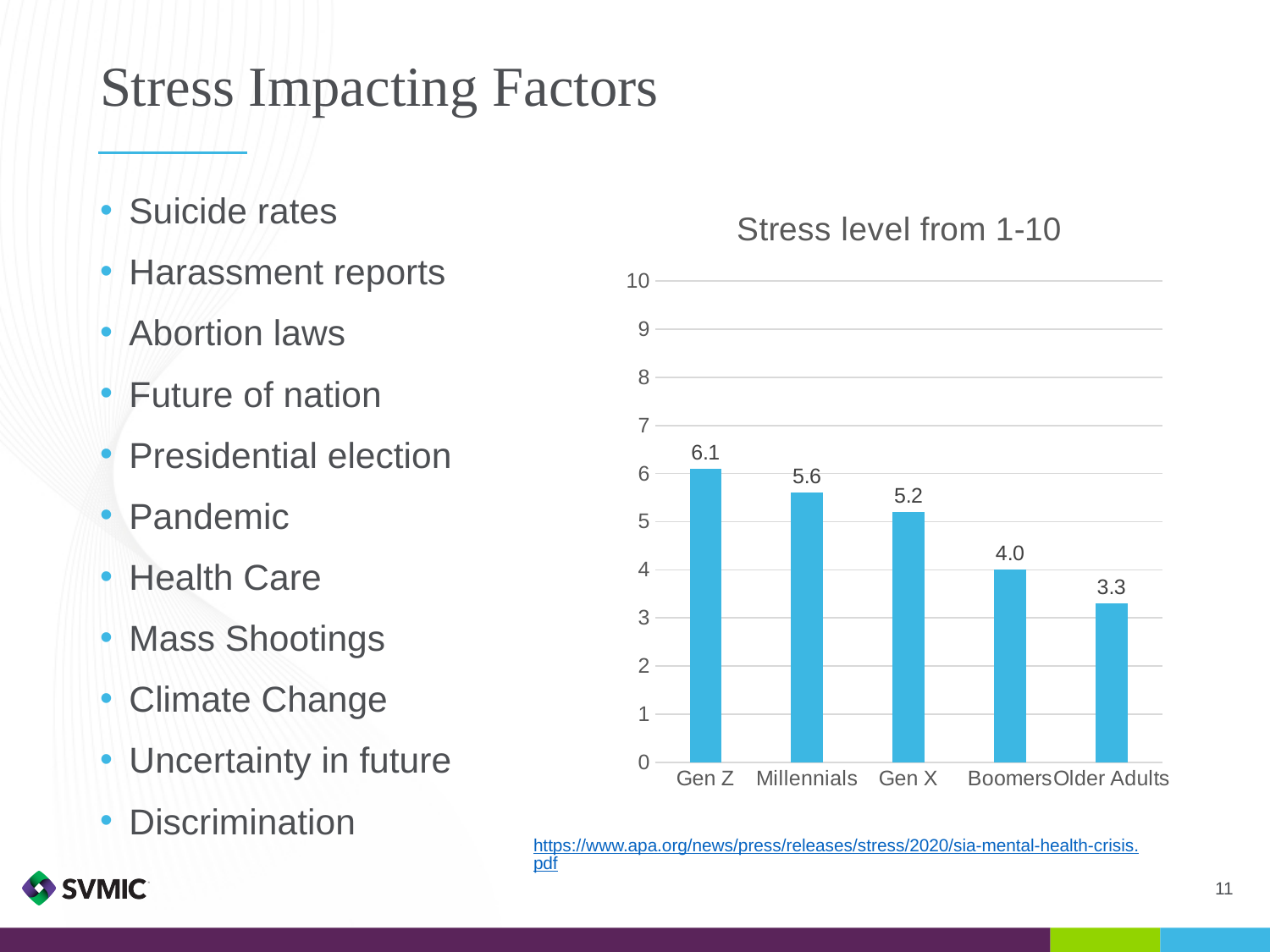
Which group has the highest stress level? Gen Z What kind of chart is shown on the slide? Bar chart Is the stress level for Gen X greater or less than 5? greater What is the stress level for Older Adults? 3.3 What is the difference between the stress levels of Gen Z and Older Adults? 2.8 What is the stress level for Boomers? 4.0 What is the title of the chart? Stress level from 1-10 How many groups are shown in the chart? 5 What is the stress level for Gen Z? 6.1 What is the stress level for Millennials? 5.6 Which has a higher stress level, Gen X or Boomers? Gen X Which group has the lowest stress level? Older Adults